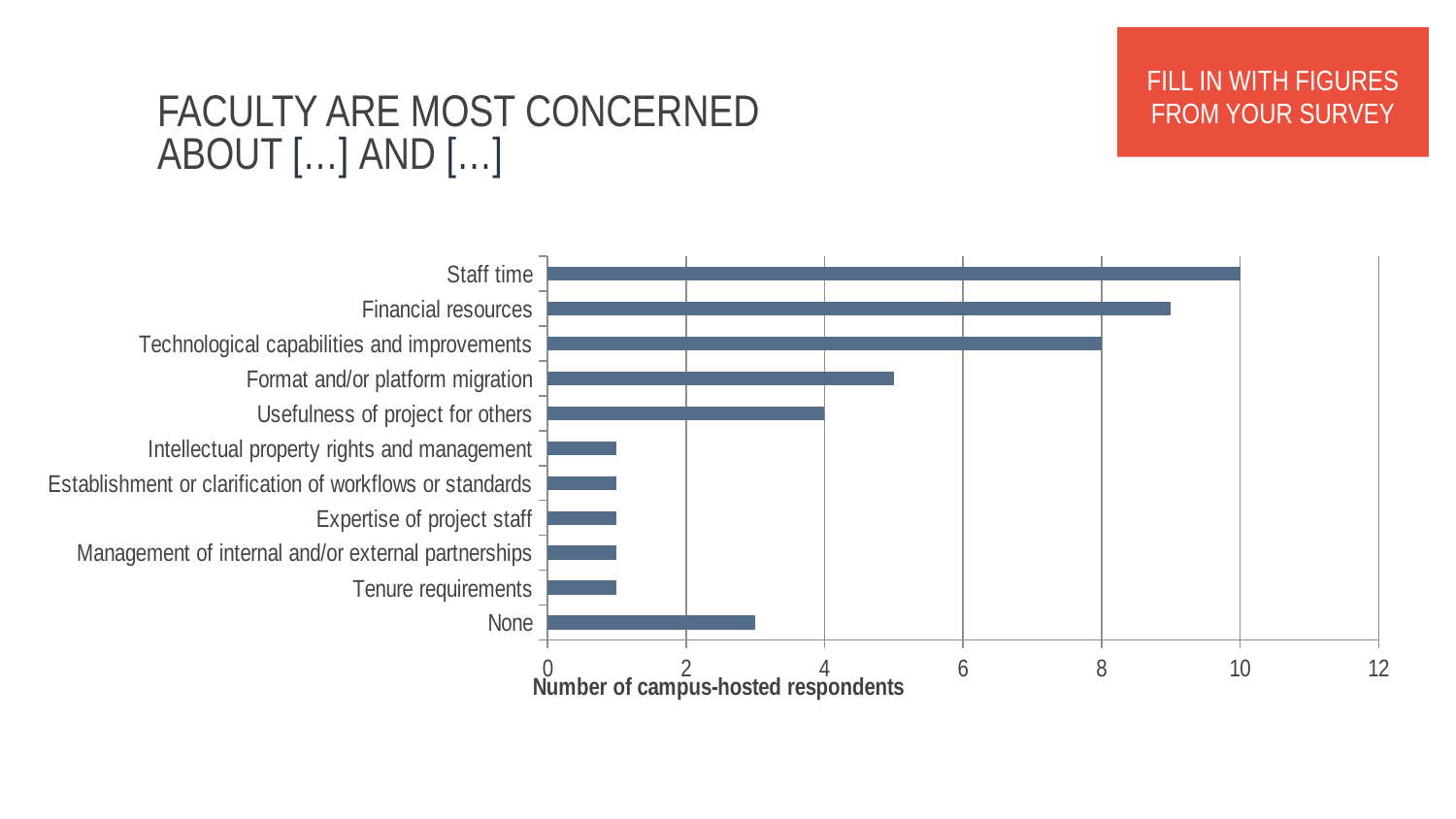
Which is larger, the value for Staff time or the value for Financial resources? Staff time What kind of chart is shown on the slide? Bar chart How many categories are shown in the chart? 11 Which category has the highest value? Staff time What is the difference between the values for Staff time and Technological capabilities and improvements? 2 What is the value for Usefulness of project for others? 4 Is the value for Tenure requirements greater or less than 2? less Is the value for Financial resources greater or less than 8? greater Is the value for None greater or less than 4? less What is the value for Staff time? 10 What is the value for Technological capabilities and improvements? 8 What is the difference between the values for Technological capabilities and improvements and Usefulness of project for others? 4